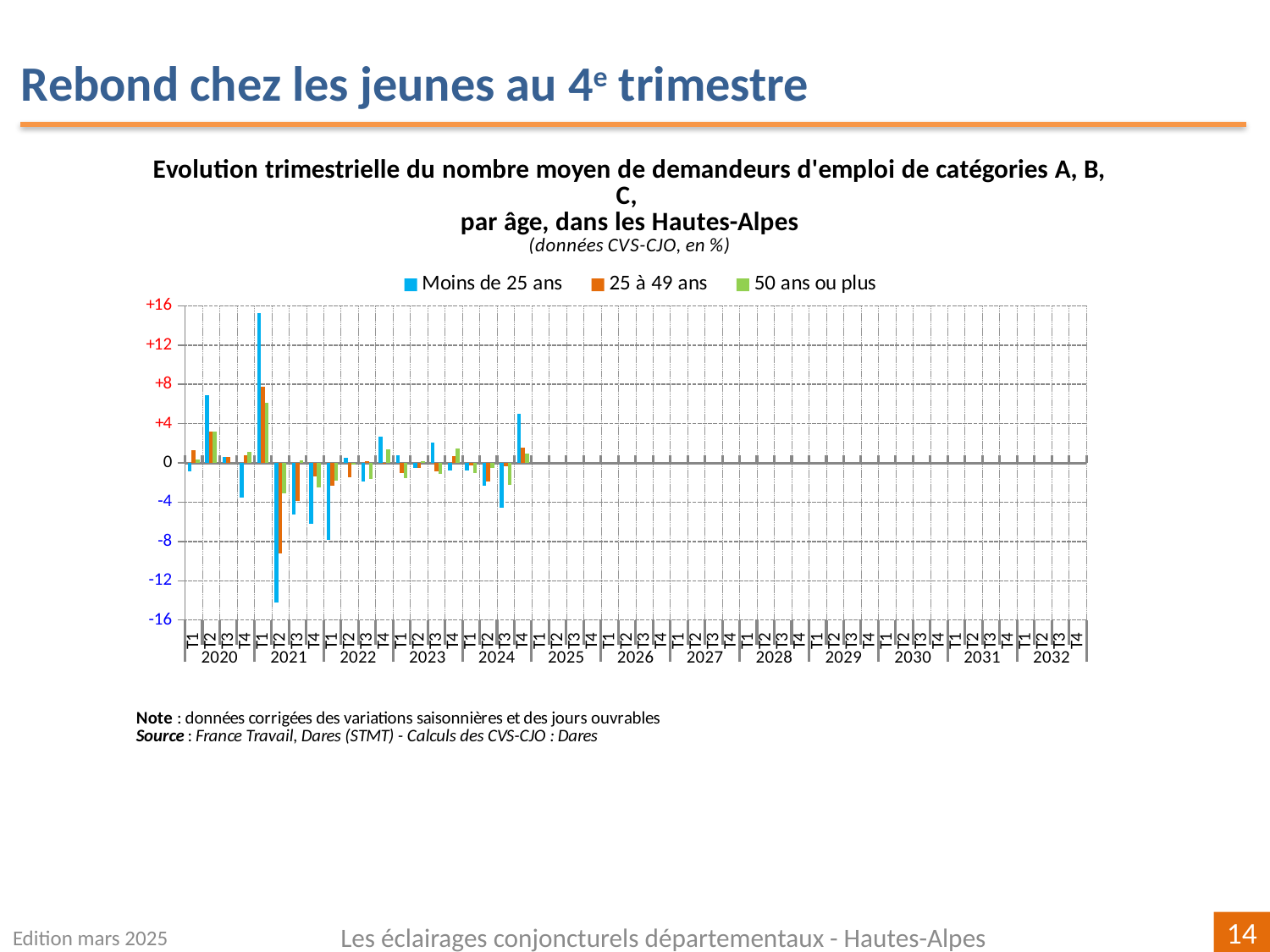
What kind of chart is shown on the slide? bar chart Is the value for '25 à 49 ans' in T2 2021 greater or less than -8? less In which quarter does the 'Moins de 25 ans' series reach its highest value? T1 2021 In T1 2021, which series has the larger value: 'Moins de 25 ans' or '25 à 49 ans'? Moins de 25 ans How many series does the chart legend list? 3 In which quarter does the 'Moins de 25 ans' series reach its lowest value? T2 2021 Is the value for 'Moins de 25 ans' in T2 2021 greater or less than -12? less Is the value for 'Moins de 25 ans' in T1 2021 greater or less than +12? greater Which series is shown in green in the chart legend? 50 ans ou plus Which series is shown in blue in the chart? Moins de 25 ans